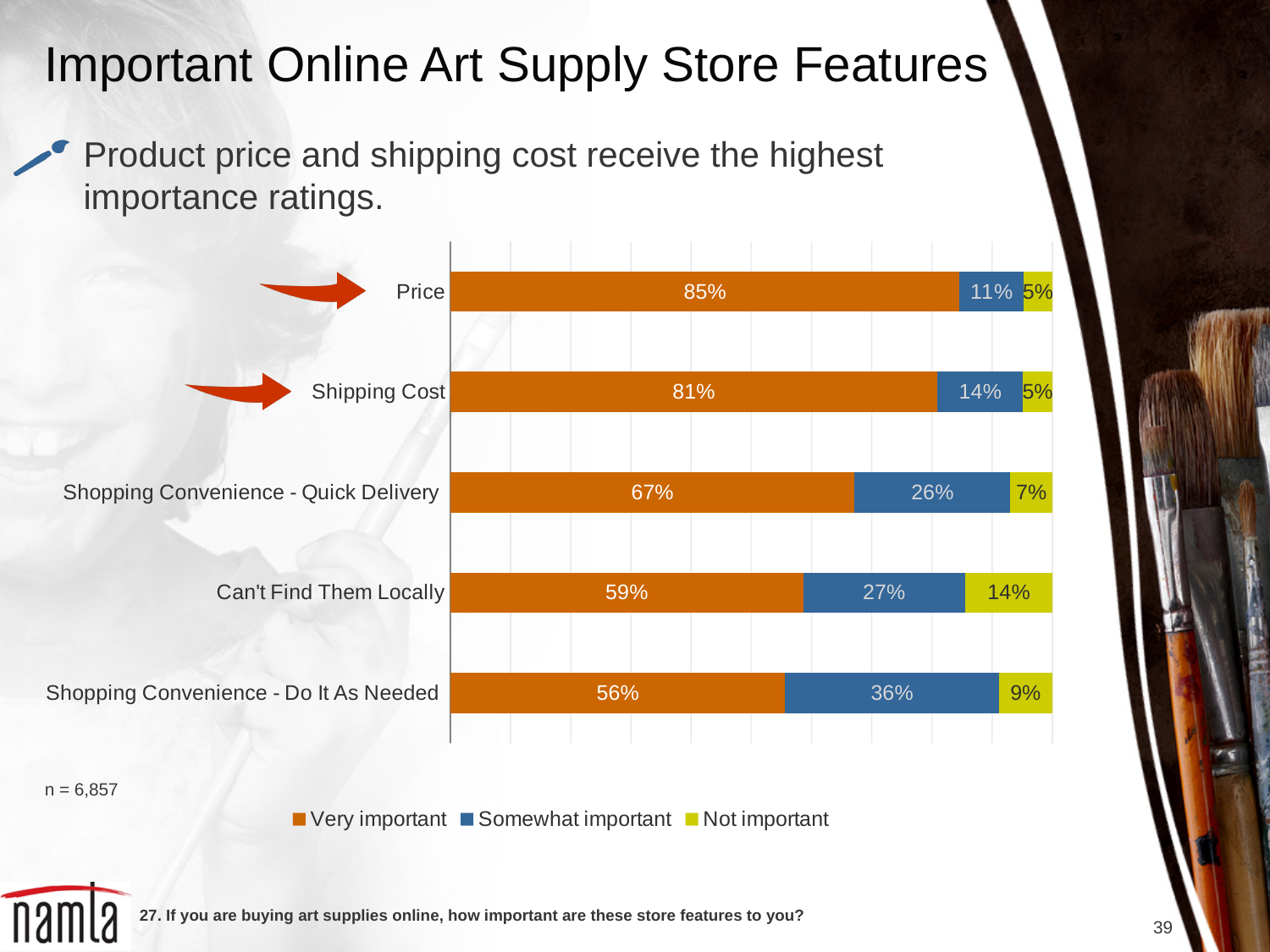
What percentage rated Price as Very important? 85% What is the difference between the Very important percentages for Price and Shipping Cost? 4% Which feature has the highest Very important percentage? Price Which feature has the lowest Very important percentage? Shopping Convenience - Do It As Needed What percentage rated Shopping Convenience - Do It As Needed as Somewhat important? 36% How many series does the legend list? 3 What kind of chart is shown on the slide? Stacked bar chart What is the sample size (n) shown on the slide? 6,857 What percentage rated Can't Find Them Locally as Not important? 14% Which has a larger Somewhat important percentage, Shopping Convenience - Quick Delivery or Can't Find Them Locally? Can't Find Them Locally How many features are shown in the chart? 5 What percentage rated Shipping Cost as Somewhat important? 14%